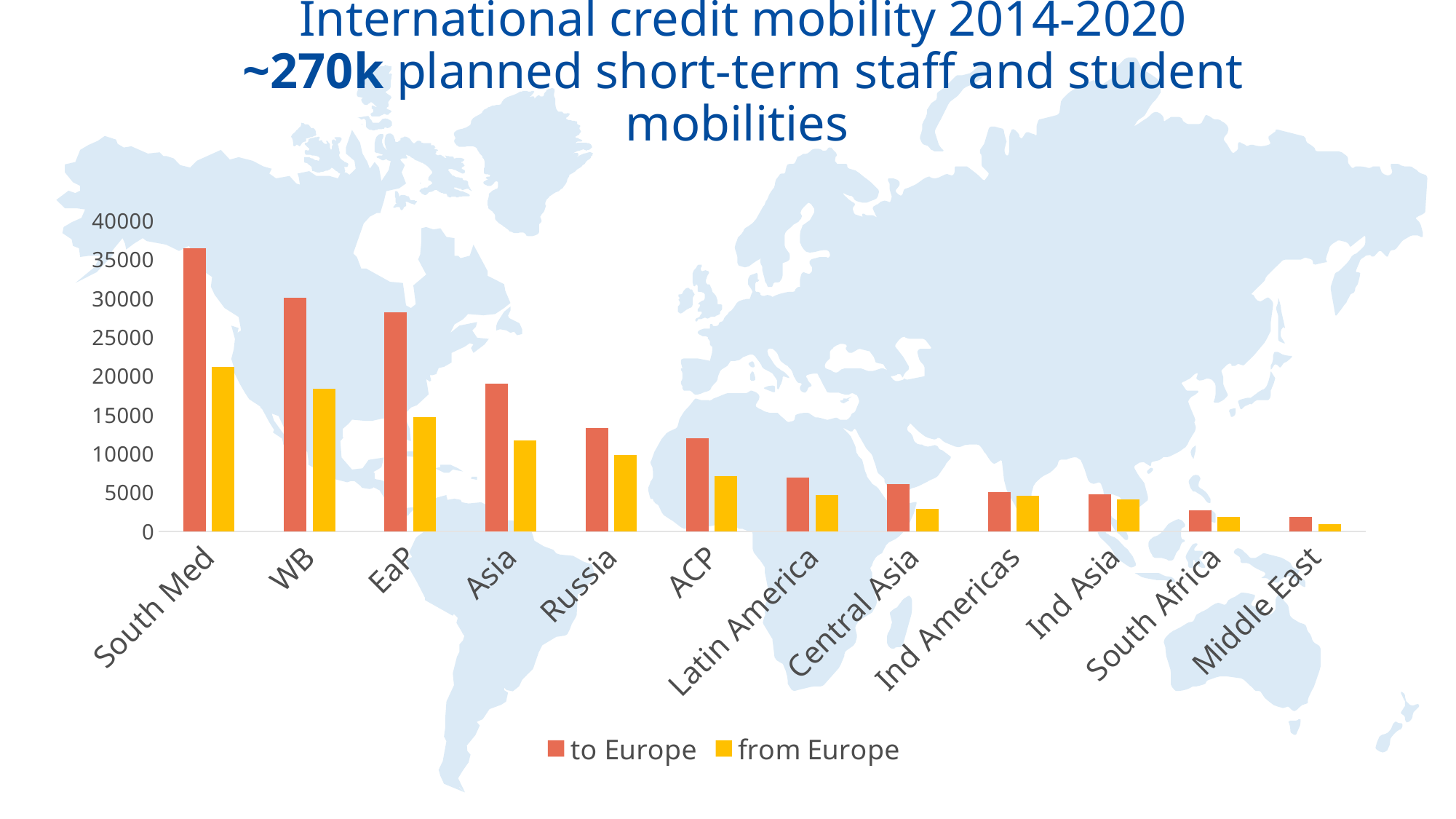
Is the 'from Europe' value for Asia greater or less than 10000? greater Which region has the lowest 'from Europe' value? Middle East Is the 'to Europe' value for South Med greater or less than 35000? greater Is the 'to Europe' value for EaP greater or less than 30000? less Do the 'to Europe' values rise or fall moving from left to right along the x axis? fall How many series does the legend list? 2 Which region has the highest 'to Europe' value? South Med How many regions are shown on the x axis? 12 Which is larger: the 'to Europe' value for Asia or the 'to Europe' value for Russia? Asia What kind of chart is shown on the slide? bar chart Which colour represents the 'from Europe' series? yellow